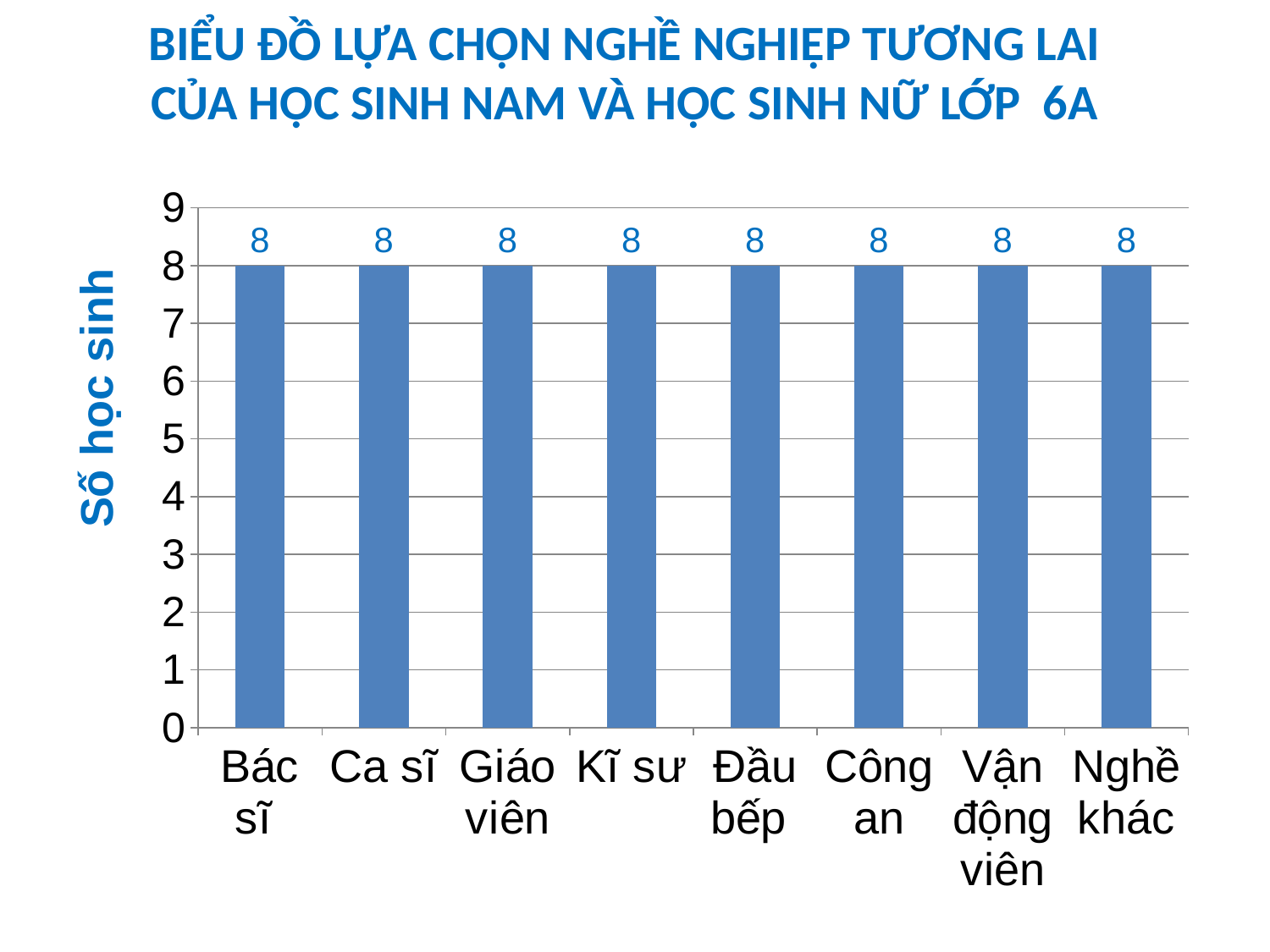
What is the value for Bác sĩ? 8 What is the value for Nghề khác? 8 Do the values rise, fall, or stay the same across the categories from Bác sĩ to Nghề khác? stay the same What is the value for Giáo viên? 8 Is the value for Kĩ sư greater or less than 5? greater What is the highest tick value shown on the vertical axis? 9 What is the value for Vận động viên? 8 Is the value for Đầu bếp greater or less than 9? less What is the difference between the values for Ca sĩ and Công an? 0 What kind of chart is shown on the slide? bar chart What is the label of the vertical axis? Số học sinh How many categories are shown on the x axis? 8